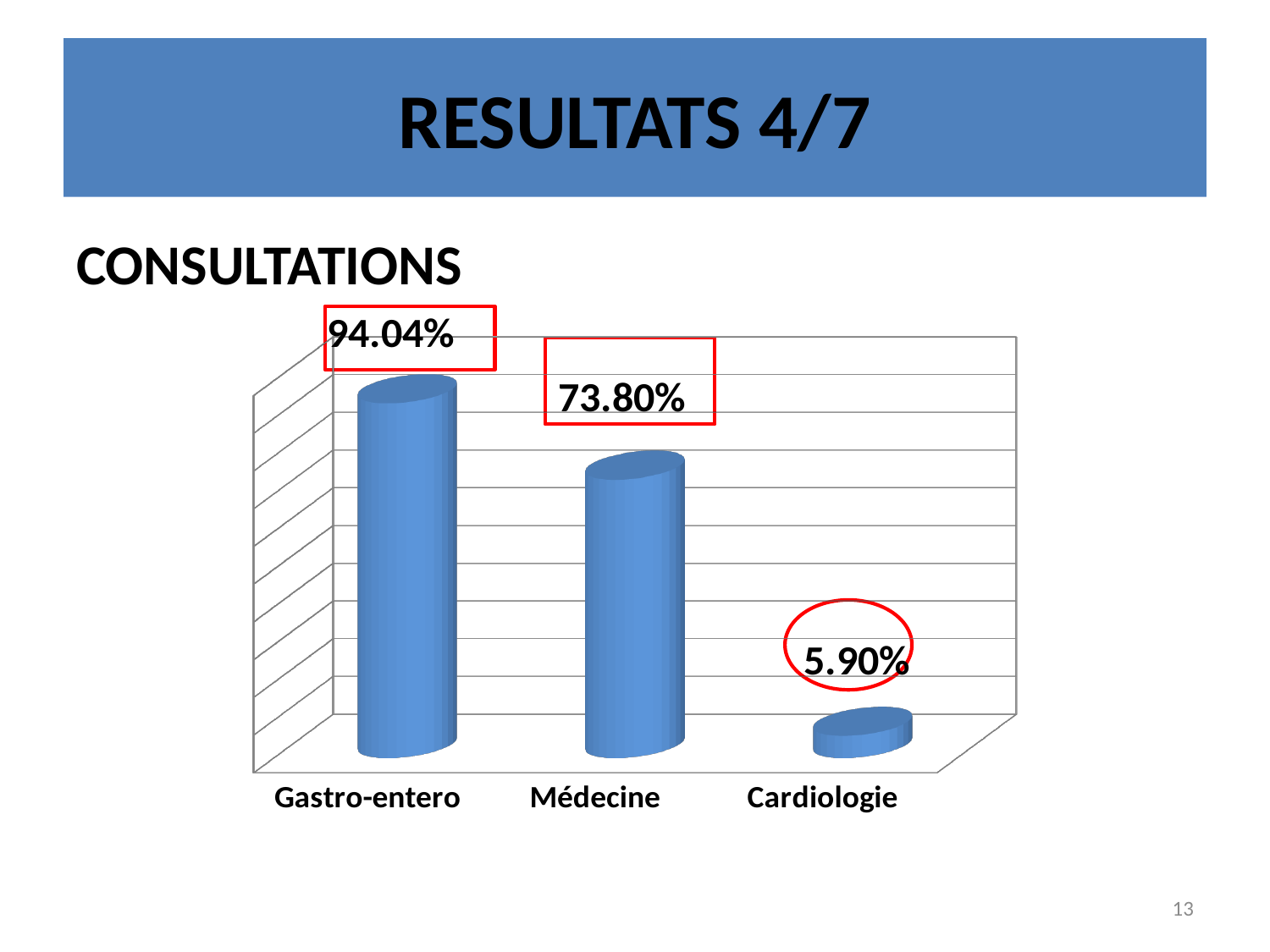
Which is larger, the value for Médecine or the value for Cardiologie? Médecine What is the value for Cardiologie? 5.90% What is the heading shown above the chart? CONSULTATIONS What kind of chart is shown on the slide? Bar chart What is the value for Gastro-entero? 94.04% Which category has the highest value? Gastro-entero What is the value for Médecine? 73.80% What is the difference between the values for Gastro-entero and Médecine? 20.24% Do the values rise or fall from left to right along the x axis? Fall How many categories are shown in the chart? 3 What is the difference between the values for Médecine and Cardiologie? 67.90% Which category has the lowest value? Cardiologie